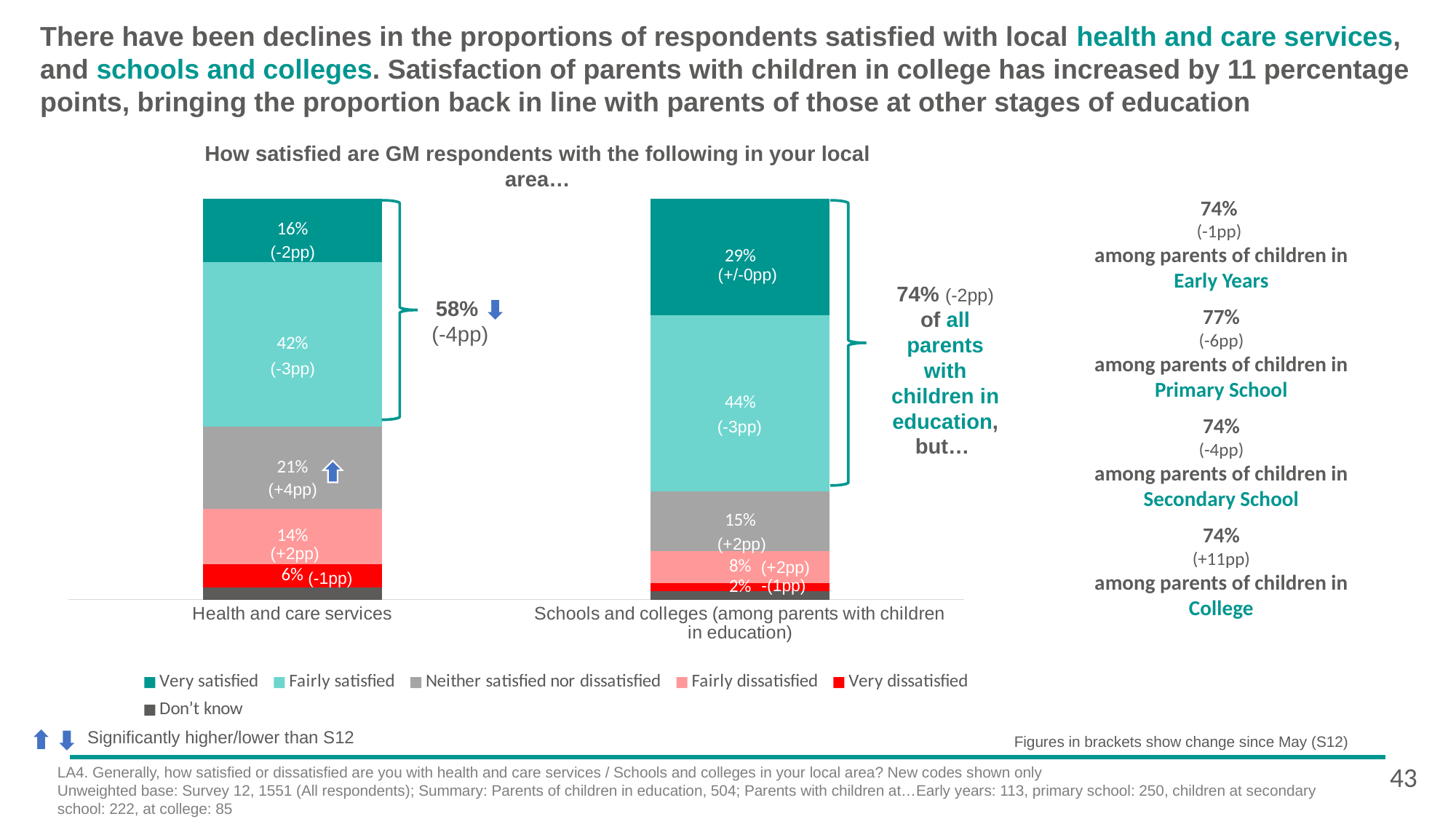
What percentage of respondents are very satisfied with health and care services? 16% How many categories (bars) are shown in the chart? 2 What is the combined very satisfied and fairly satisfied share for health and care services? 58% How many series does the chart legend list? 6 Which has the larger very satisfied share: health and care services or schools and colleges? Schools and colleges What percentage of respondents are very dissatisfied with schools and colleges? 2% What percentage of respondents are neither satisfied nor dissatisfied with health and care services? 21% What percentage of respondents are fairly dissatisfied with health and care services? 14% What is the combined very satisfied and fairly satisfied share for schools and colleges? 73% What percentage of parents with children in education are fairly satisfied with schools and colleges? 44% What is the difference in percentage points between the very satisfied share for schools and colleges and for health and care services? 13 percentage points What type of chart is shown on the slide? Stacked bar chart